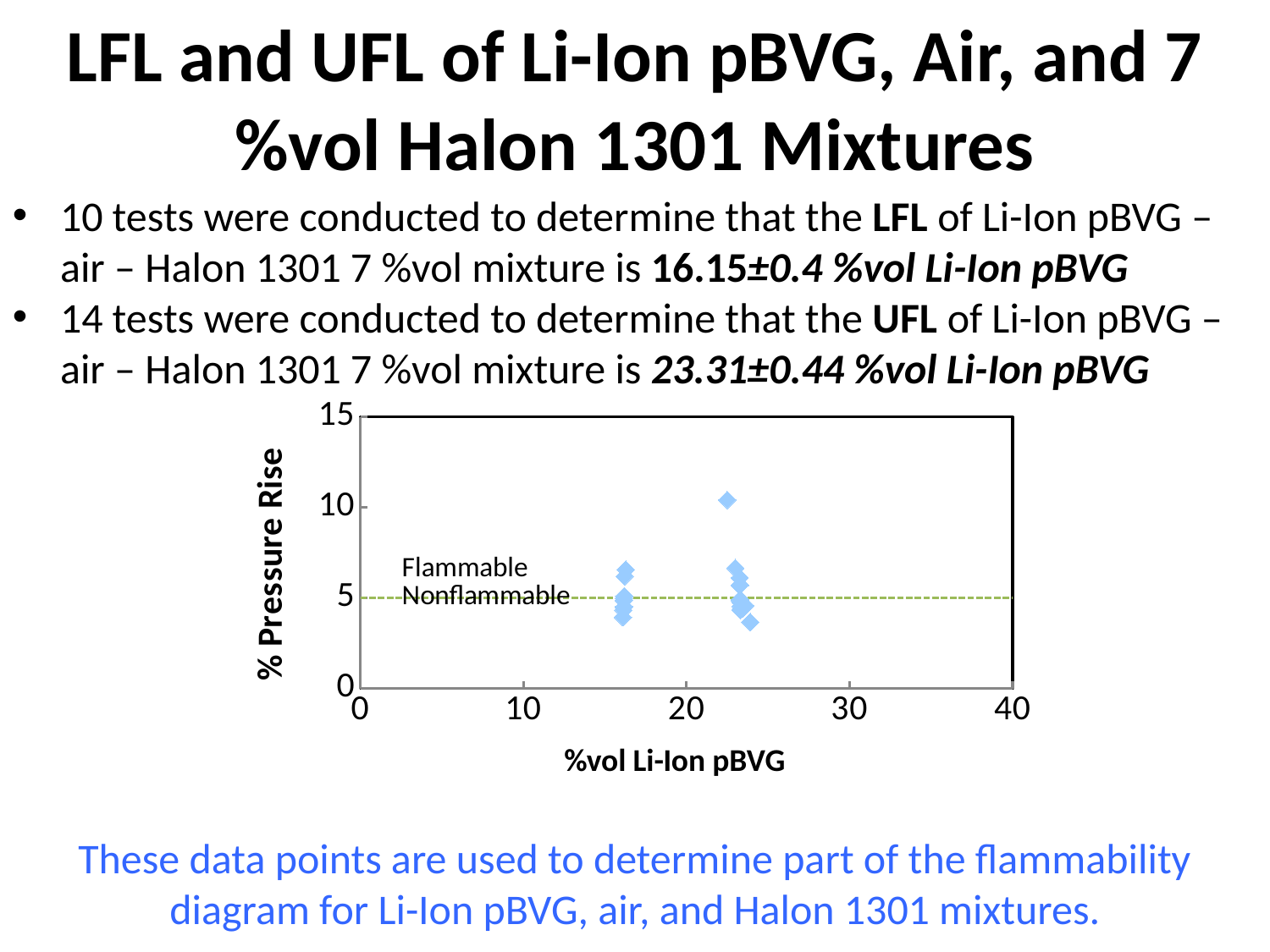
Are all plotted points in the chart less than 15 on the % Pressure Rise axis? yes What is the title of the y axis of the chart? % Pressure Rise Are there any data points plotted between 0 and 10 on the x axis of the chart? no What kind of chart is shown on the slide? scatter chart What is the highest value shown on the x axis of the chart? 40 What is the title of the x axis of the chart? %vol Li-Ion pBVG Is the lowest plotted point in the chart greater or less than 5 on the % Pressure Rise axis? less Which cluster of points contains the highest % Pressure Rise value: the one near 16 %vol or the one near 23 %vol? the one near 23 %vol